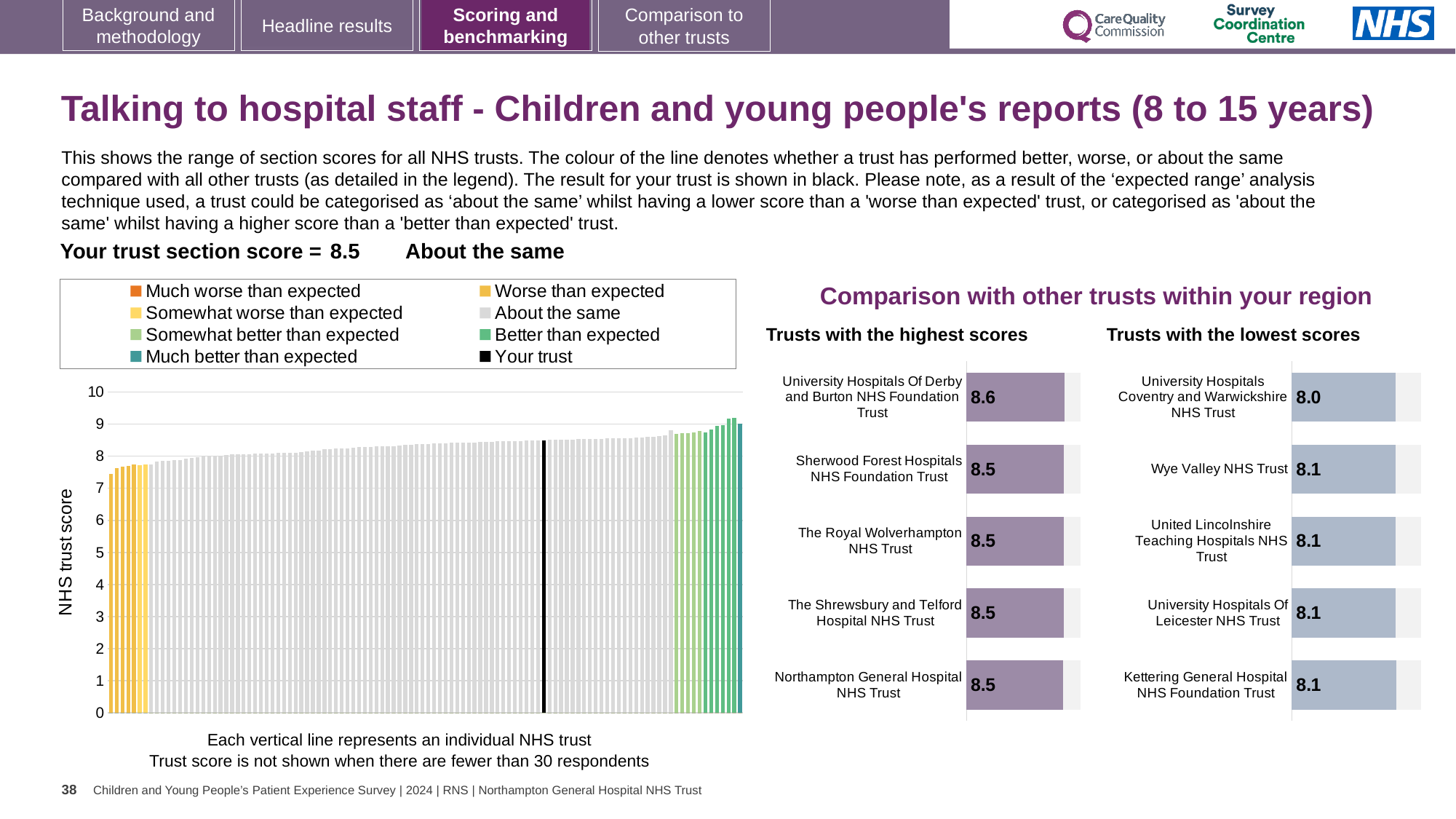
In the large chart on the left, is the value for the black bar (Your trust) greater or less than 8? greater In the 'Trusts with the highest scores' chart, what is the score for University Hospitals Of Derby and Burton NHS Foundation Trust? 8.6 How many trusts are shown in the 'Trusts with the highest scores' chart? 5 In the 'Trusts with the highest scores' chart, which trust has the highest score? University Hospitals Of Derby and Burton NHS Foundation Trust In the 'Trusts with the lowest scores' chart, which trust has the lowest score? University Hospitals Coventry and Warwickshire NHS Trust In the large chart on the left, what is the label on the vertical axis? NHS trust score Which is larger: the score for University Hospitals Of Derby and Burton NHS Foundation Trust in the 'Trusts with the highest scores' chart, or the score for University Hospitals Coventry and Warwickshire NHS Trust in the 'Trusts with the lowest scores' chart? University Hospitals Of Derby and Burton NHS Foundation Trust How many entries does the legend above the large chart on the left list? 8 In the 'Trusts with the lowest scores' chart, what is the score for Wye Valley NHS Trust? 8.1 What kind of chart is the large chart on the left showing the range of section scores for all NHS trusts? bar chart In the 'Trusts with the highest scores' chart, what is the difference between the scores of University Hospitals Of Derby and Burton NHS Foundation Trust and Northampton General Hospital NHS Trust? 0.1 In the large chart on the left, is the value for the lowest (leftmost) bar greater or less than 7? greater